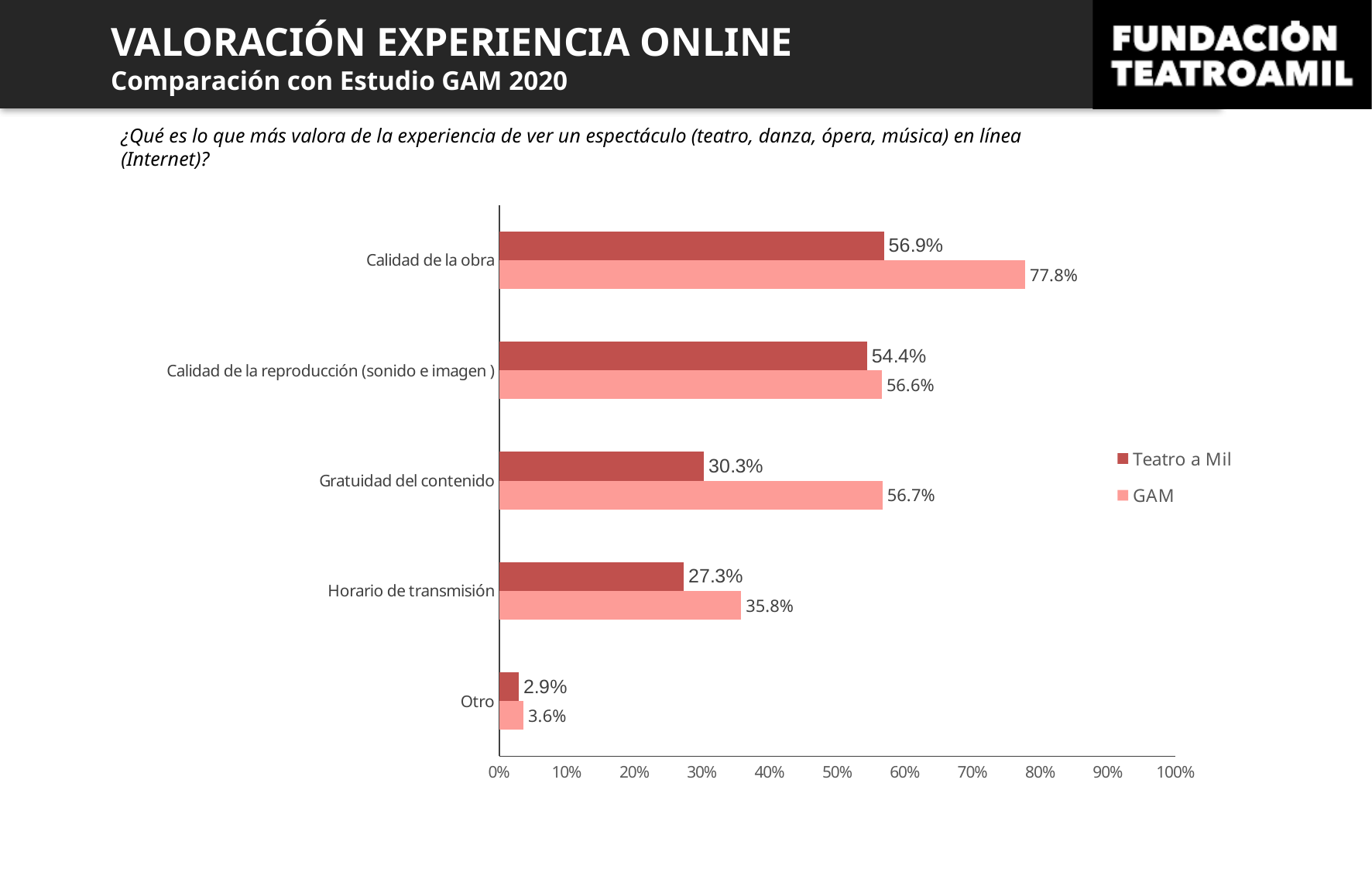
What is the Teatro a Mil value for Otro? 2.9% Which category has the lowest Teatro a Mil value? Otro What is the Teatro a Mil value for Calidad de la obra? 56.9% Which is larger for Horario de transmisión, the Teatro a Mil value or the GAM value? GAM What is the difference between the GAM and Teatro a Mil values for Gratuidad del contenido? 26.4% Which category has the highest GAM value? Calidad de la obra What is the difference between the GAM and Teatro a Mil values for Calidad de la obra? 20.9% How many categories are shown on the chart? 5 How many series does the legend list? 2 What is the GAM value for Horario de transmisión? 35.8% What kind of chart is shown on the slide? Bar chart What is the GAM value for Gratuidad del contenido? 56.7%